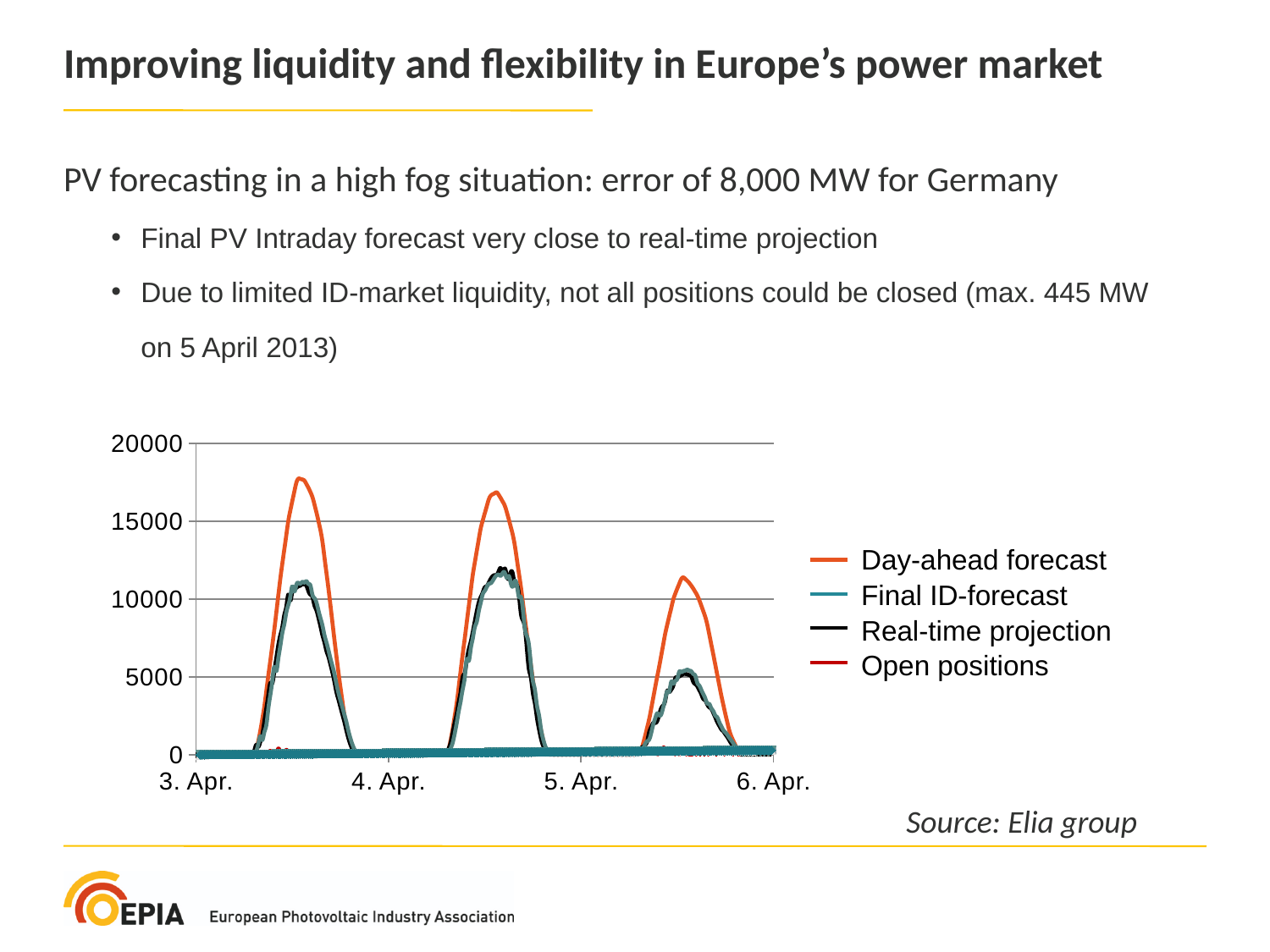
Is the peak of the Day-ahead forecast on 5 April greater or less than 10000? greater What kind of chart is shown on the slide? line chart How many dates are labelled on the x axis of the chart? 4 Do the daily peaks of the Day-ahead forecast rise or fall from 3 April to 5 April? fall Is the peak of the Final ID-forecast on 3 April greater or less than 15000? less How many series does the chart's legend list? 4 Is the peak of the Real-time projection on 5 April greater or less than 10000? less Which series reaches the highest peak on the chart? Day-ahead forecast What colour is the Day-ahead forecast line in the chart? orange Which is larger on 4 April: the peak of the Day-ahead forecast or the peak of the Final ID-forecast? Day-ahead forecast